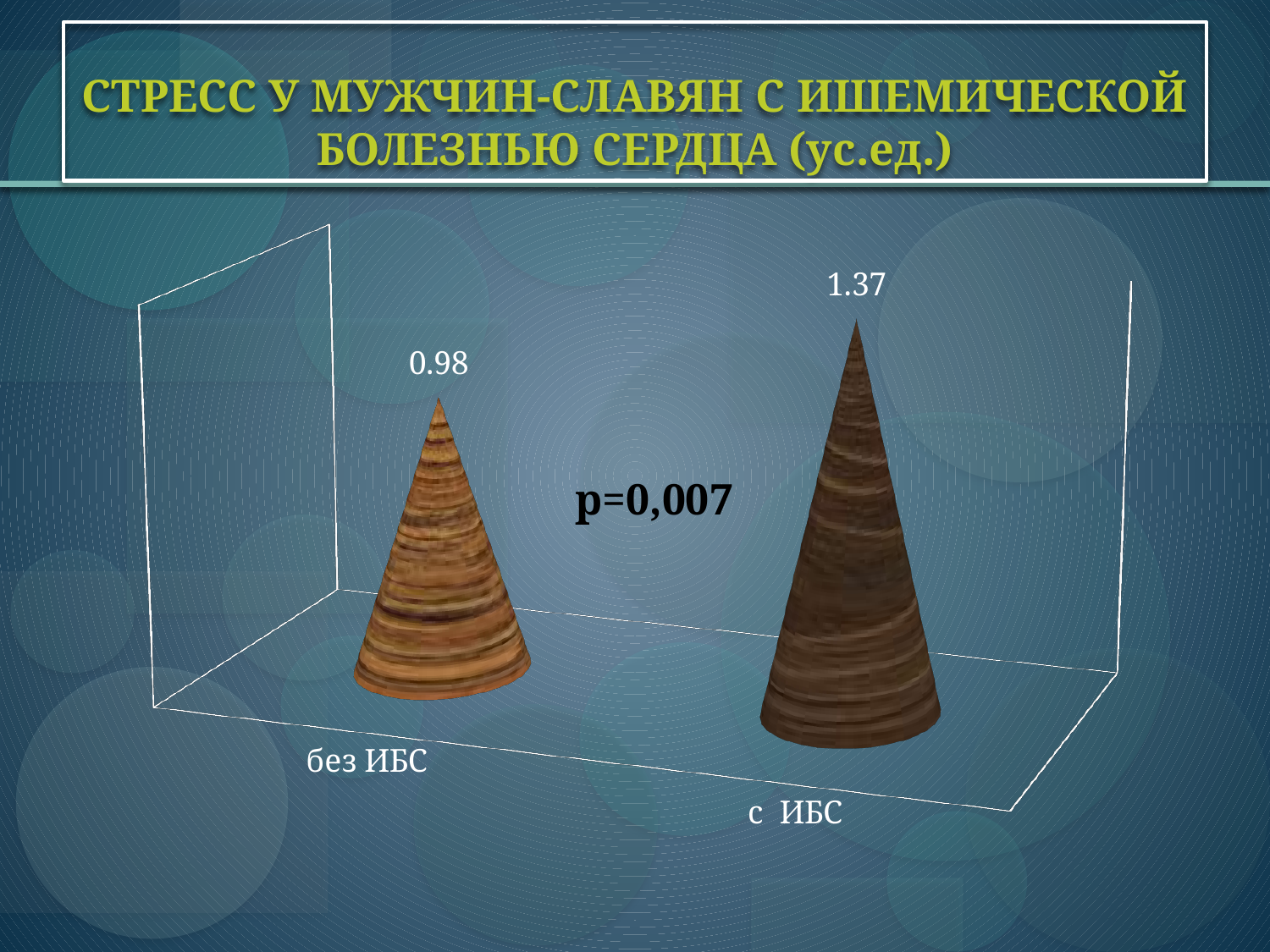
How many categories are shown in the chart? 2 Which category has the highest value? с ИБС What is the title of the chart? СТРЕСС У МУЖЧИН-СЛАВЯН С ИШЕМИЧЕСКОЙ БОЛЕЗНЬЮ СЕРДЦА (ус.ед.) What is the value for "с ИБС"? 1.37 What p-value is printed on the chart? p=0,007 Which is larger, the value for "без ИБС" or the value for "с ИБС"? с ИБС What is the difference between the values for "с ИБС" and "без ИБС"? 0.39 Which category has the lowest value? без ИБС What is the value for "без ИБС"? 0.98 What kind of chart is shown on the slide? bar chart Do the values rise or fall from "без ИБС" to "с ИБС"? rise